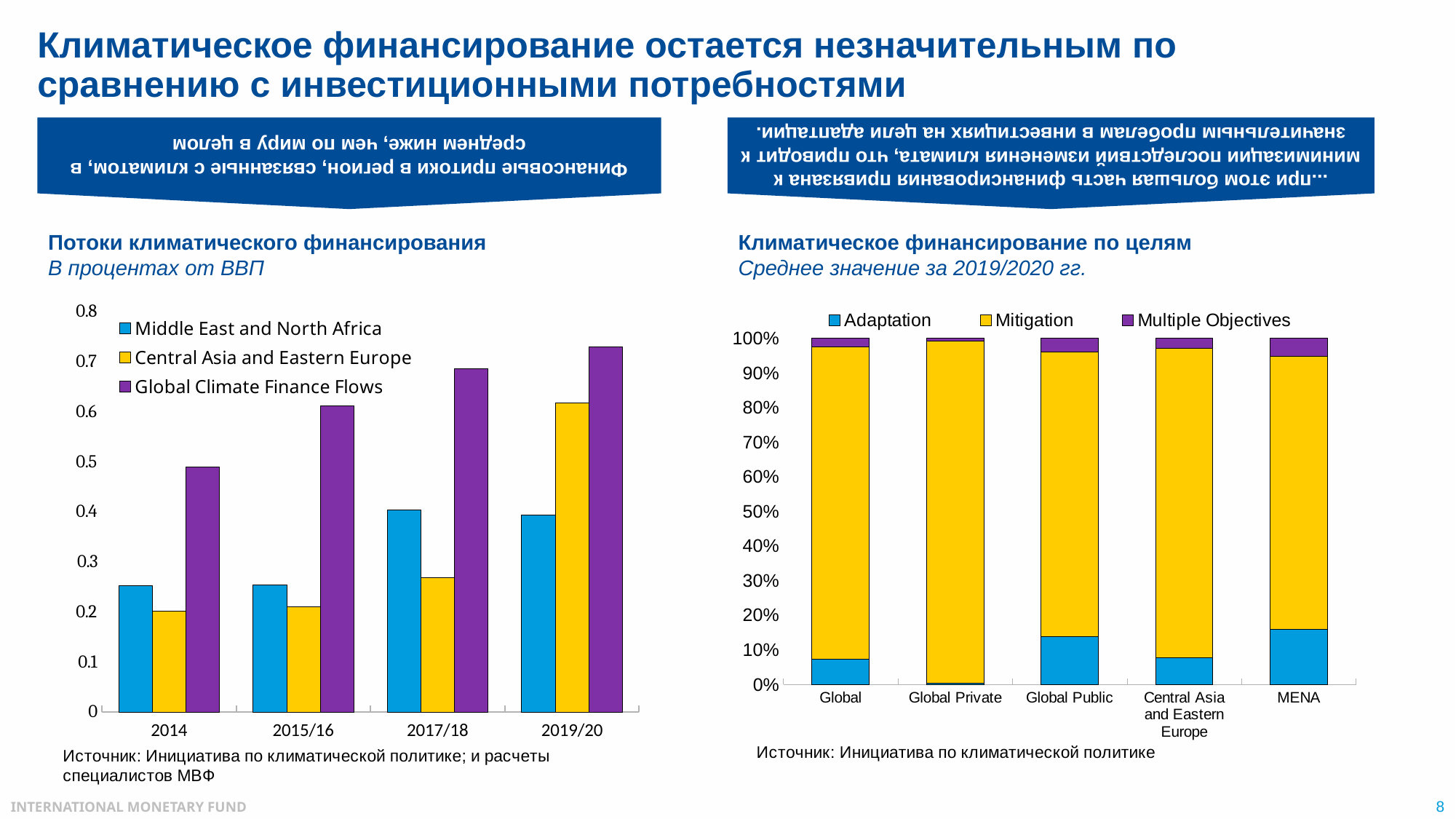
In the chart titled "Климатическое финансирование по целям", which category has the largest Adaptation share? MENA In the chart titled "Климатическое финансирование по целям", how many categories are shown on the x axis? 5 In the chart titled "Потоки климатического финансирования", which series has the highest value in 2019/20? Global Climate Finance Flows In the chart titled "Потоки климатического финансирования", how many time periods are shown on the x axis? 4 In the chart titled "Потоки климатического финансирования", does the Global Climate Finance Flows series rise or fall from 2014 to 2019/20? rise In the chart titled "Потоки климатического финансирования", which series has the lowest value in 2017/18? Central Asia and Eastern Europe What kind of chart is the chart titled "Климатическое финансирование по целям"? stacked bar chart In the chart titled "Потоки климатического финансирования", is the value for Global Climate Finance Flows in 2019/20 greater or less than 0.7? greater In the chart titled "Потоки климатического финансирования", how many series does the legend list? 3 In the chart titled "Потоки климатического финансирования", which is larger in 2019/20: Middle East and North Africa or Central Asia and Eastern Europe? Central Asia and Eastern Europe In the chart titled "Климатическое финансирование по целям", is the Adaptation share for Global Public greater or less than 10%? greater In the chart titled "Потоки климатического финансирования", is the value for Central Asia and Eastern Europe in 2014 greater or less than 0.3? less